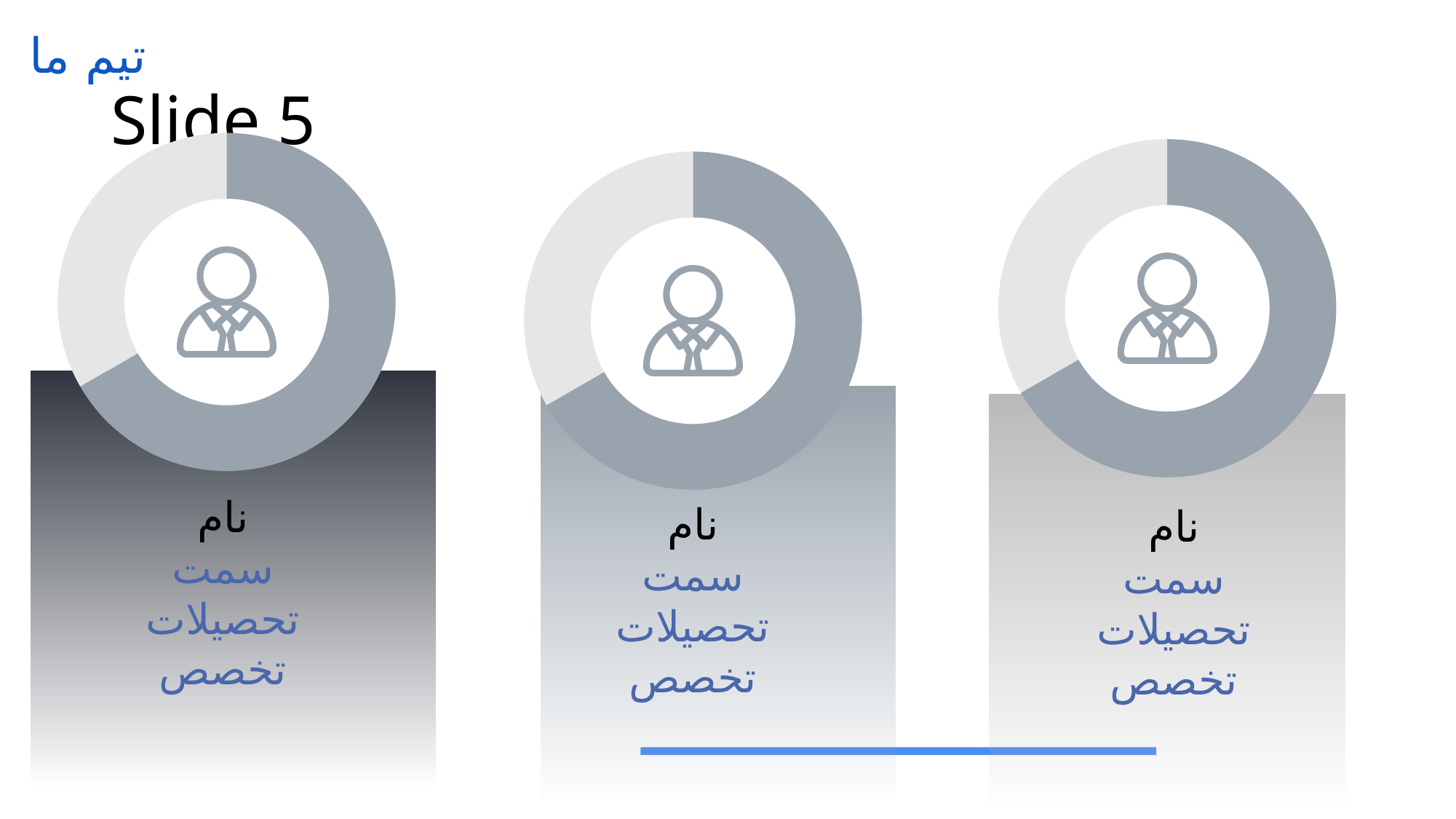
In the right doughnut chart, which slice is larger, the dark gray one or the light gray one? the dark gray one Do the doughnut charts on the slide show any data labels with values? No How many doughnut charts are on the slide? 3 What kind of chart is shown on the left of the slide? doughnut chart In the middle doughnut chart, which slice is larger, the dark gray one or the light gray one? the dark gray one In the middle doughnut chart, how many slices are there? 2 In the left doughnut chart, how many slices are there? 2 In the left doughnut chart, which slice is larger, the dark gray one or the light gray one? the dark gray one In the right doughnut chart, how many slices are there? 2